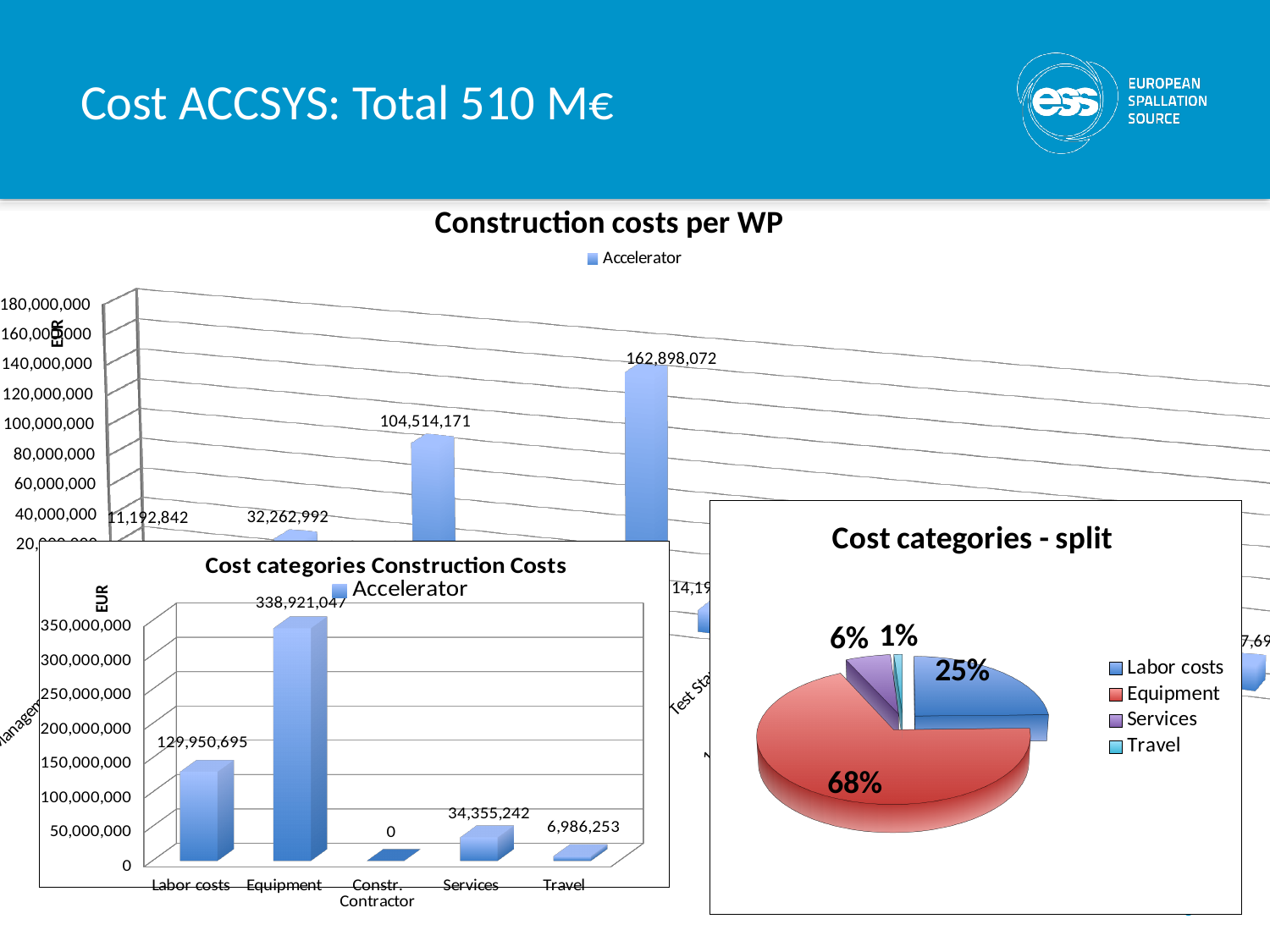
In the 'Cost categories Construction Costs' chart, which category has the highest value? Equipment How many categories are shown in the 'Cost categories Construction Costs' chart? 5 In the 'Cost categories - split' pie chart, what share does Labor costs have? 25% In the 'Cost categories Construction Costs' chart, what is the value for Labor costs? 129,950,695 In the 'Cost categories Construction Costs' chart, what is the value for Equipment? 338,921,047 In the 'Cost categories Construction Costs' chart, what is the value for Travel? 6,986,253 What kind of chart is 'Construction costs per WP'? Bar chart In the 'Cost categories Construction Costs' chart, what is the difference between the Equipment and Labor costs values? 208,970,352 In the 'Cost categories - split' pie chart, what share does Equipment have? 68% How many entries does the legend of the 'Cost categories - split' pie chart list? 4 In the 'Cost categories Construction Costs' chart, which category has the lowest value? Constr. Contractor In the 'Cost categories Construction Costs' chart, which is larger: Services or Travel? Services